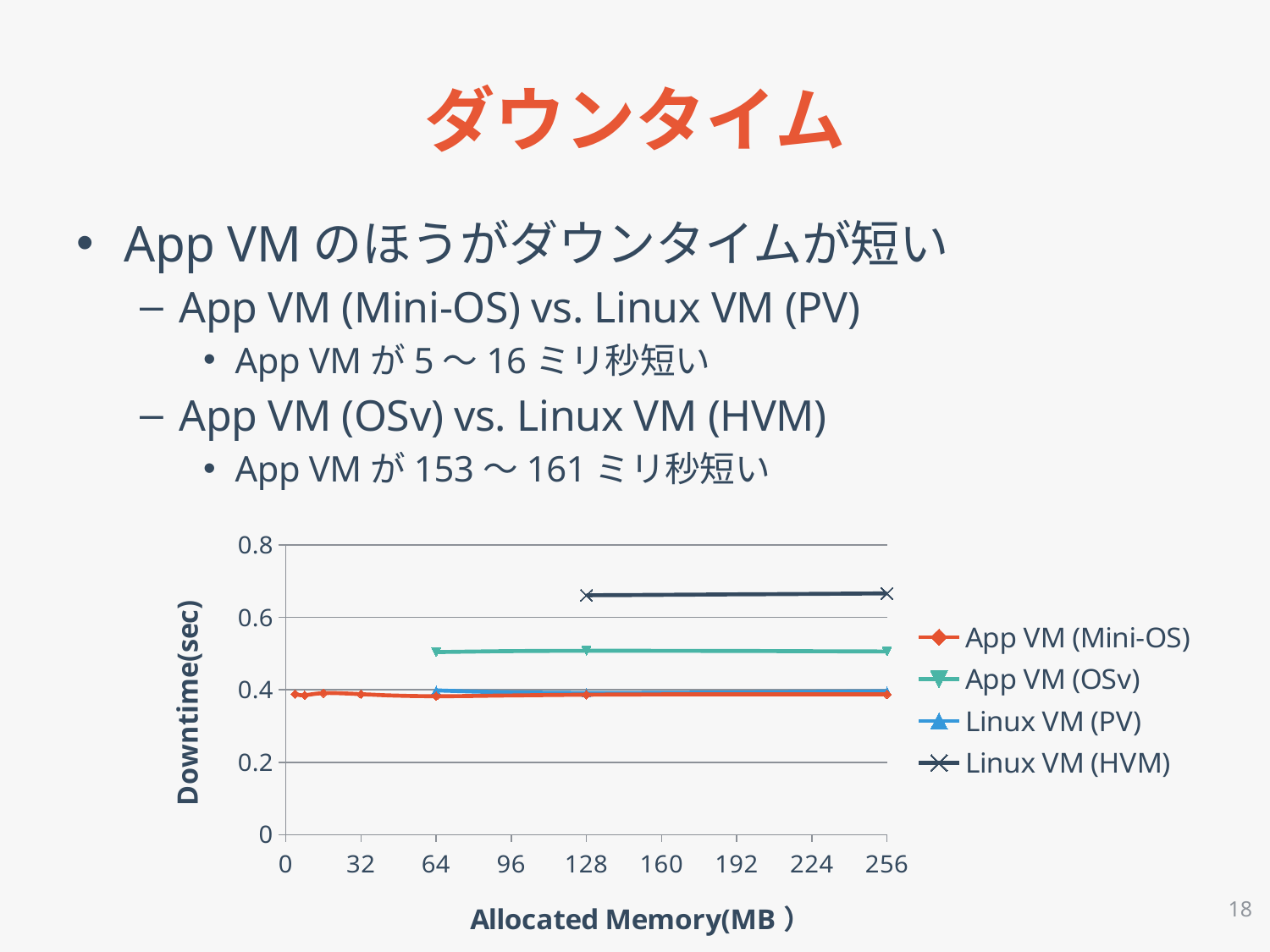
Is the downtime for App VM (OSv) at 64 MB greater or less than 0.6? less Is the downtime for App VM (Mini-OS) at 128 MB greater or less than 0.6? less How many series does the chart legend list? 4 Is the downtime for App VM (OSv) at 256 MB greater or less than 0.4? greater Which series has the highest downtime values in the chart? Linux VM (HVM) What is the label of the x axis of the chart? Allocated Memory(MB ) At 128 MB, which has the larger downtime: Linux VM (HVM) or App VM (OSv)? Linux VM (HVM) What kind of chart is shown on the slide? line chart What is the label of the y axis of the chart? Downtime(sec) Does the downtime for Linux VM (HVM) rise, fall, or stay roughly flat from 128 MB to 256 MB? roughly flat At 256 MB, which has the larger downtime: App VM (OSv) or Linux VM (PV)? App VM (OSv)